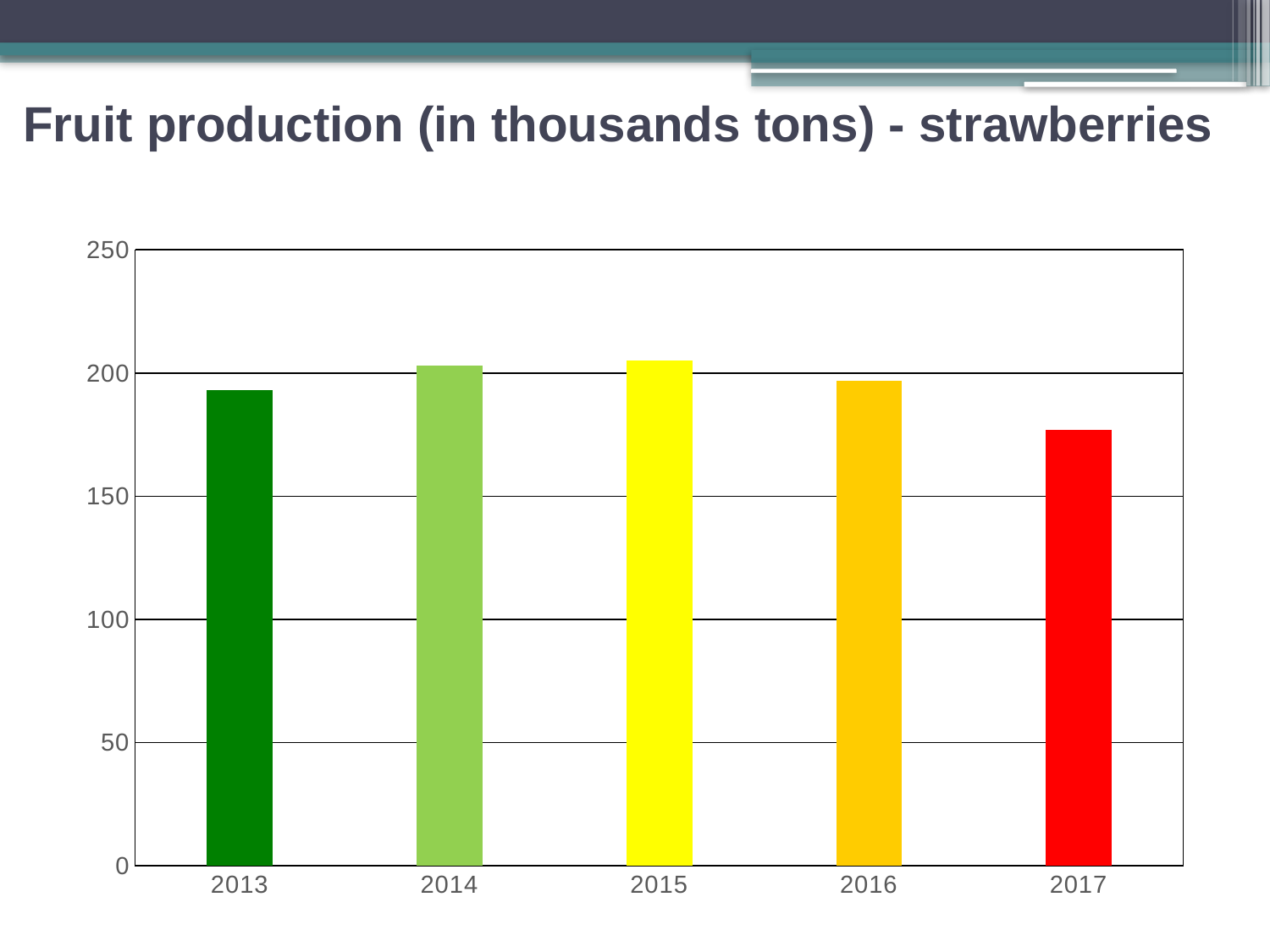
Is the value for 2013 greater or less than 200? less Is the value for 2017 greater or less than 150? greater Which is larger, the value for 2015 or the value for 2016? 2015 What kind of chart is shown on the slide? bar chart Do the values rise or fall from 2015 to 2017? fall Which is larger, the value for 2013 or the value for 2017? 2013 Which year has the lowest strawberry production? 2017 Is the value for 2015 greater or less than 200? greater What colour is the bar for 2017? red How many years are shown on the x axis of the chart? 5 What is the title of the slide? Fruit production (in thousands tons) - strawberries